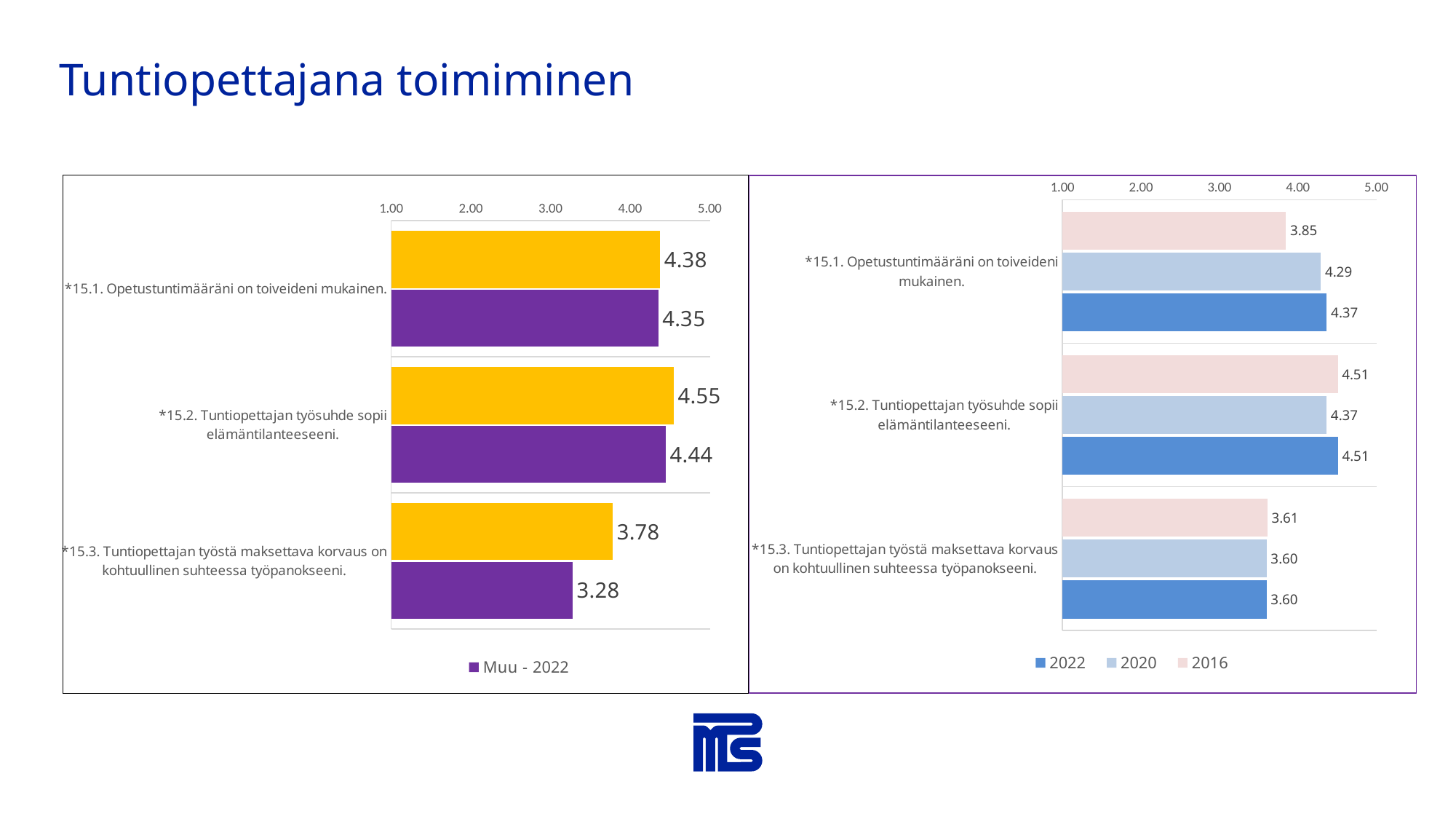
In the left chart, which category has the lowest Muu - 2022 value? *15.3. Tuntiopettajan työstä maksettava korvaus on kohtuullinen suhteessa työpanokseeni. What kind of chart is the right chart? Bar chart In the right chart, what is the 2016 value for "*15.1. Opetustuntimääräni on toiveideni mukainen."? 3.85 In the right chart, how many series does the legend list? 3 What is the legend entry shown in the left chart? Muu - 2022 In the left chart, what is the value of the yellow bar for "*15.2. Tuntiopettajan työsuhde sopii elämäntilanteeseeni."? 4.55 In the right chart, which is larger for "*15.1. Opetustuntimääräni on toiveideni mukainen.": the 2022 value or the 2016 value? 2022 In the right chart, what is the 2020 value for "*15.2. Tuntiopettajan työsuhde sopii elämäntilanteeseeni."? 4.37 In the left chart, how many categories are shown? 3 In the left chart, what is the difference between the yellow bar and the Muu - 2022 bar for "*15.3. Tuntiopettajan työstä maksettava korvaus on kohtuullinen suhteessa työpanokseeni."? 0.50 In the right chart, what is the difference between the 2022 and 2020 values for "*15.1. Opetustuntimääräni on toiveideni mukainen."? 0.08 In the left chart, what is the value of the Muu - 2022 series for "*15.3. Tuntiopettajan työstä maksettava korvaus on kohtuullinen suhteessa työpanokseeni."? 3.28